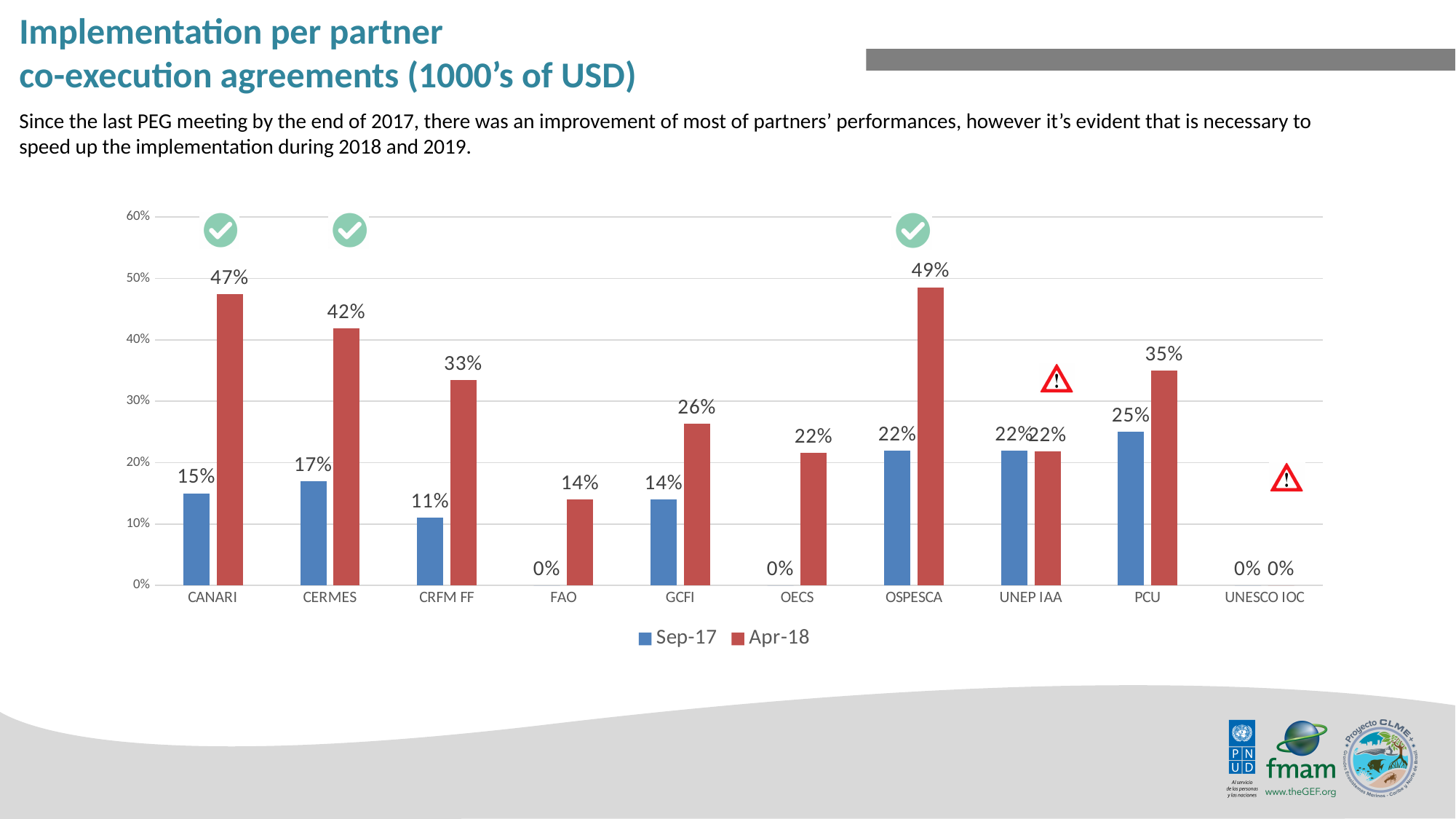
What is the difference between the Apr-18 values for CERMES and PCU? 7% How many series does the legend list? 2 Which is larger, the Apr-18 value for CRFM FF or the Apr-18 value for GCFI? CRFM FF Which partner has the highest Sep-17 value? PCU Which series is shown in red in the legend? Apr-18 Which partner has the highest Apr-18 value? OSPESCA What is the difference between the Apr-18 and Sep-17 values for CANARI? 32% What kind of chart is shown on the slide? bar chart What is the Apr-18 value for OSPESCA? 49% How many partners are shown on the x axis? 10 What is the Sep-17 value for CRFM FF? 11% What is the Apr-18 value for GCFI? 26%